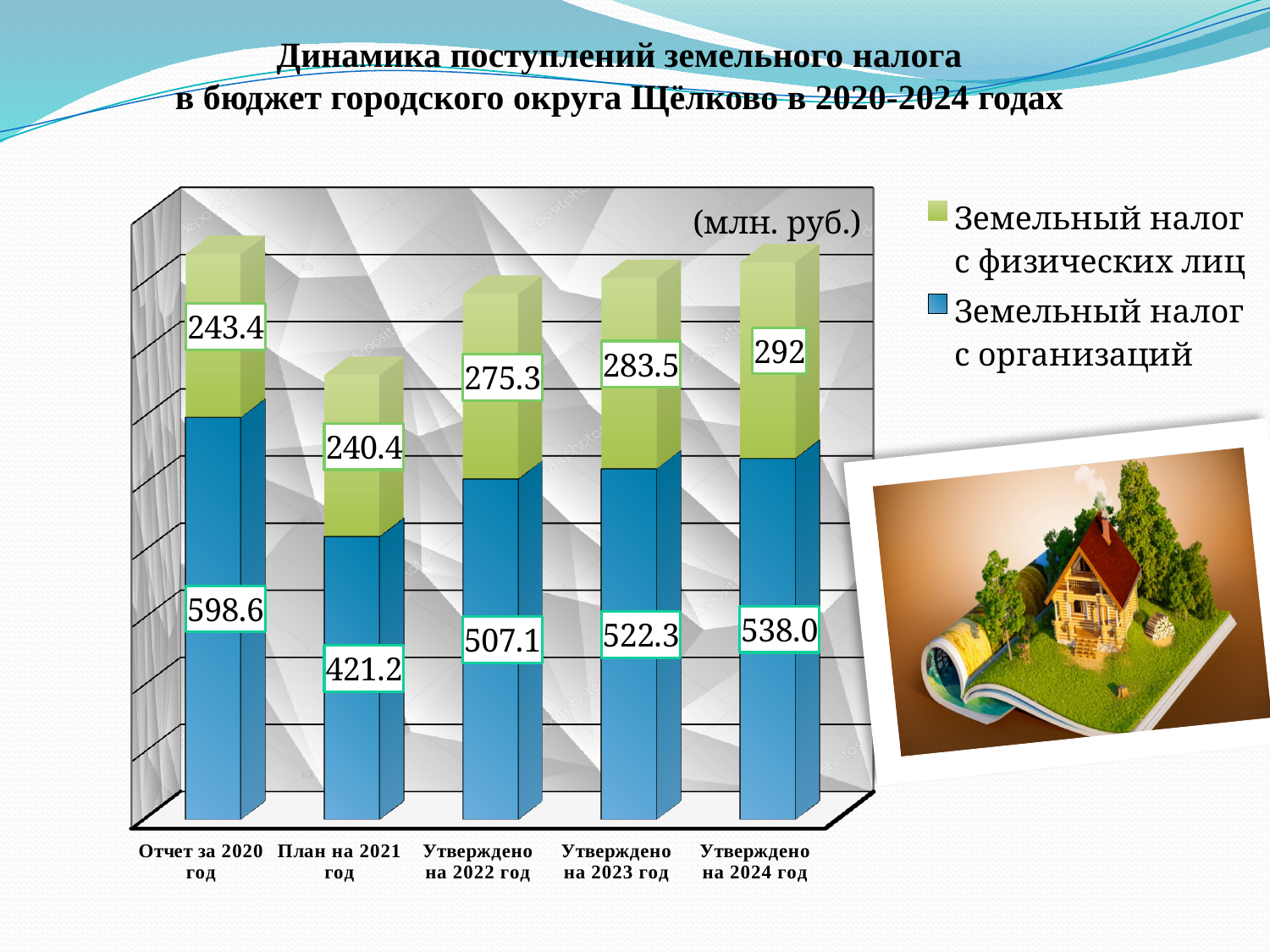
What is the total of the stacked bar for Утверждено на 2024 год? 830.0 What is the value of Земельный налог с организаций for План на 2021 год? 421.2 Which category has the highest value for Земельный налог с организаций? Отчет за 2020 год What is the value of Земельный налог с физических лиц for Утверждено на 2024 год? 292 Which is larger: Земельный налог с физических лиц for Утверждено на 2023 год or for Утверждено на 2022 год? Утверждено на 2023 год What unit is indicated in the top right corner of the chart? млн. руб. How many categories are shown on the x axis? 5 What is the value of Земельный налог с организаций for Отчет за 2020 год? 598.6 How many series does the legend list? 2 What is the difference between Земельный налог с организаций for Отчет за 2020 год and План на 2021 год? 177.4 What kind of chart is shown on the slide? Stacked bar chart Which category has the lowest value for Земельный налог с физических лиц? План на 2021 год